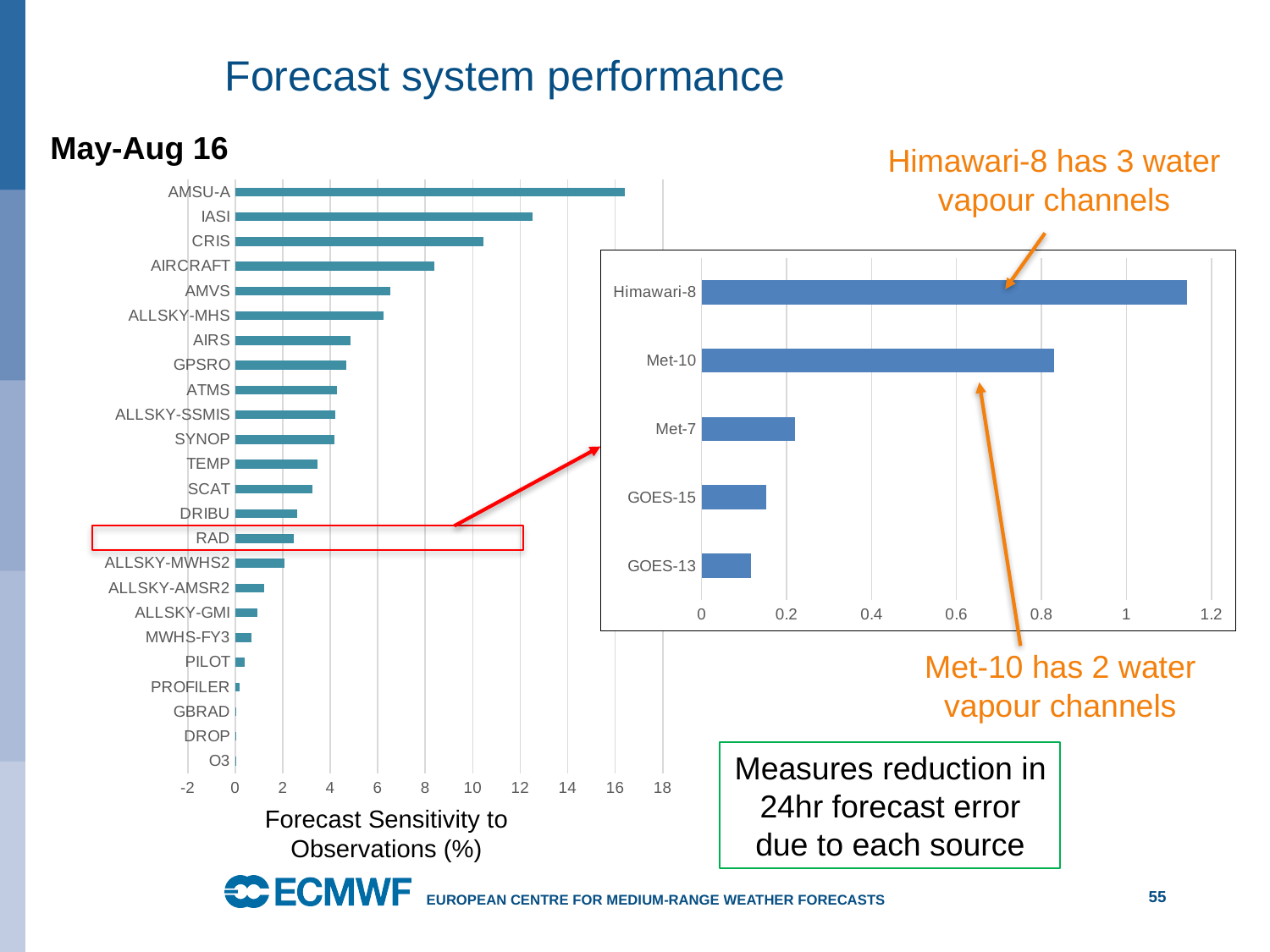
How many categories are plotted in the inset chart on the right? 5 In the inset chart on the right, is the value for Met-7 greater or less than 0.4? less In the left chart (Forecast Sensitivity to Observations), which category has the highest value? AMSU-A In the inset chart on the right, which category has the highest value? Himawari-8 How many categories are plotted in the left chart (Forecast Sensitivity to Observations)? 24 In the inset chart on the right, which category has the lowest value? GOES-13 In the left chart (Forecast Sensitivity to Observations), is the value for IASI greater or less than 10? greater In the left chart (Forecast Sensitivity to Observations), is the value for AMSU-A greater or less than 14? greater What kind of chart is the large chart on the left of the slide? bar chart In the left chart (Forecast Sensitivity to Observations), which is larger, the value for IASI or the value for CRIS? IASI In the left chart, which category is highlighted with a red box? RAD